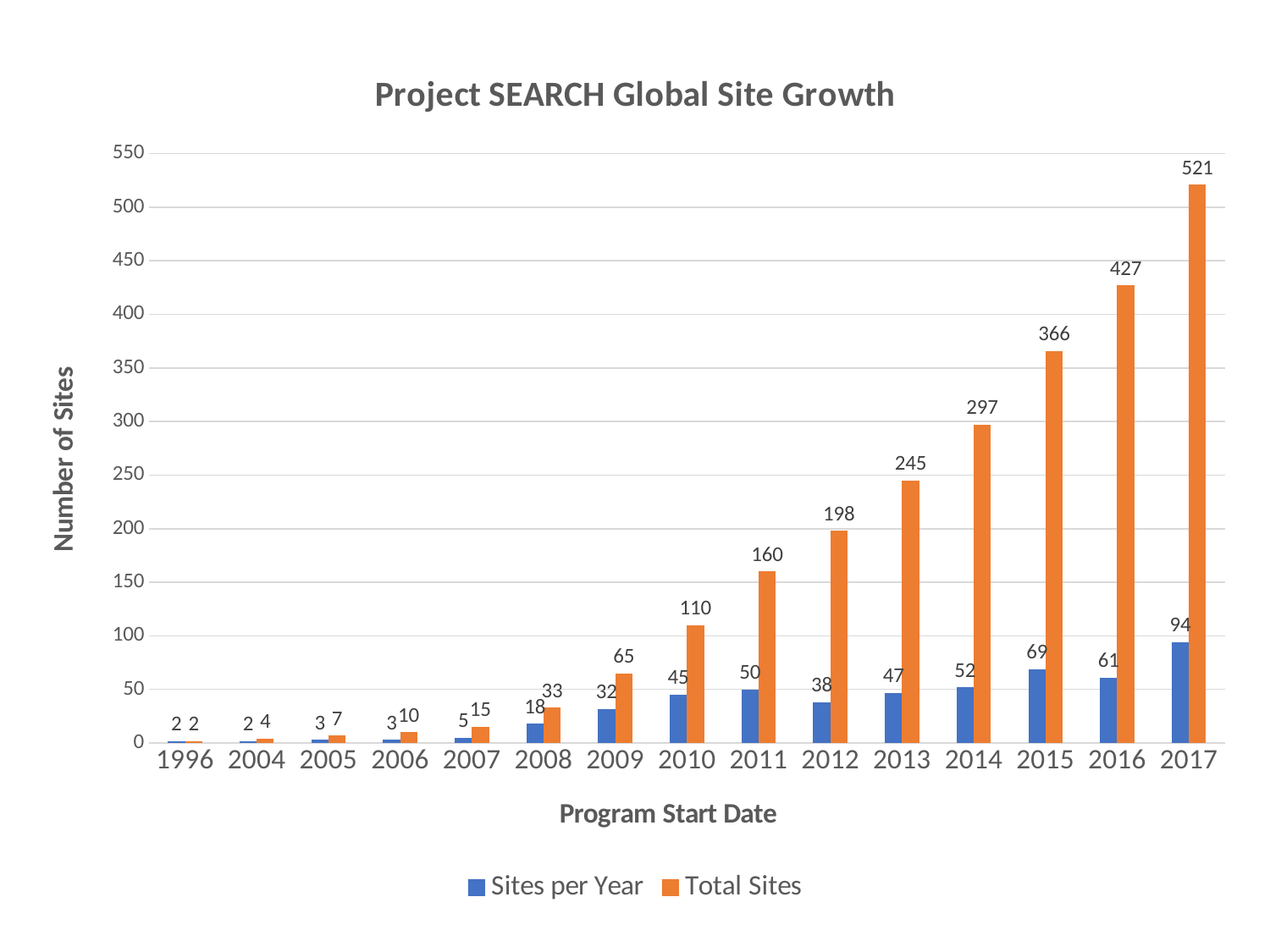
How many years are shown on the x axis? 15 Do the Total Sites values rise or fall from 1996 to 2017? rise What is the value of Sites per Year for 2013? 47 Which year has the highest value for Sites per Year? 2017 How many series does the legend list? 2 Which year has the lowest value for Total Sites? 1996 Is the value of Total Sites for 2014 greater or less than 250? greater What is the difference between Total Sites in 2017 and Total Sites in 2016? 94 Which is larger, Sites per Year in 2015 or Sites per Year in 2016? 2015 What is the value of Total Sites for 2010? 110 What is the value of Total Sites for 2017? 521 What kind of chart is shown on the slide? bar chart